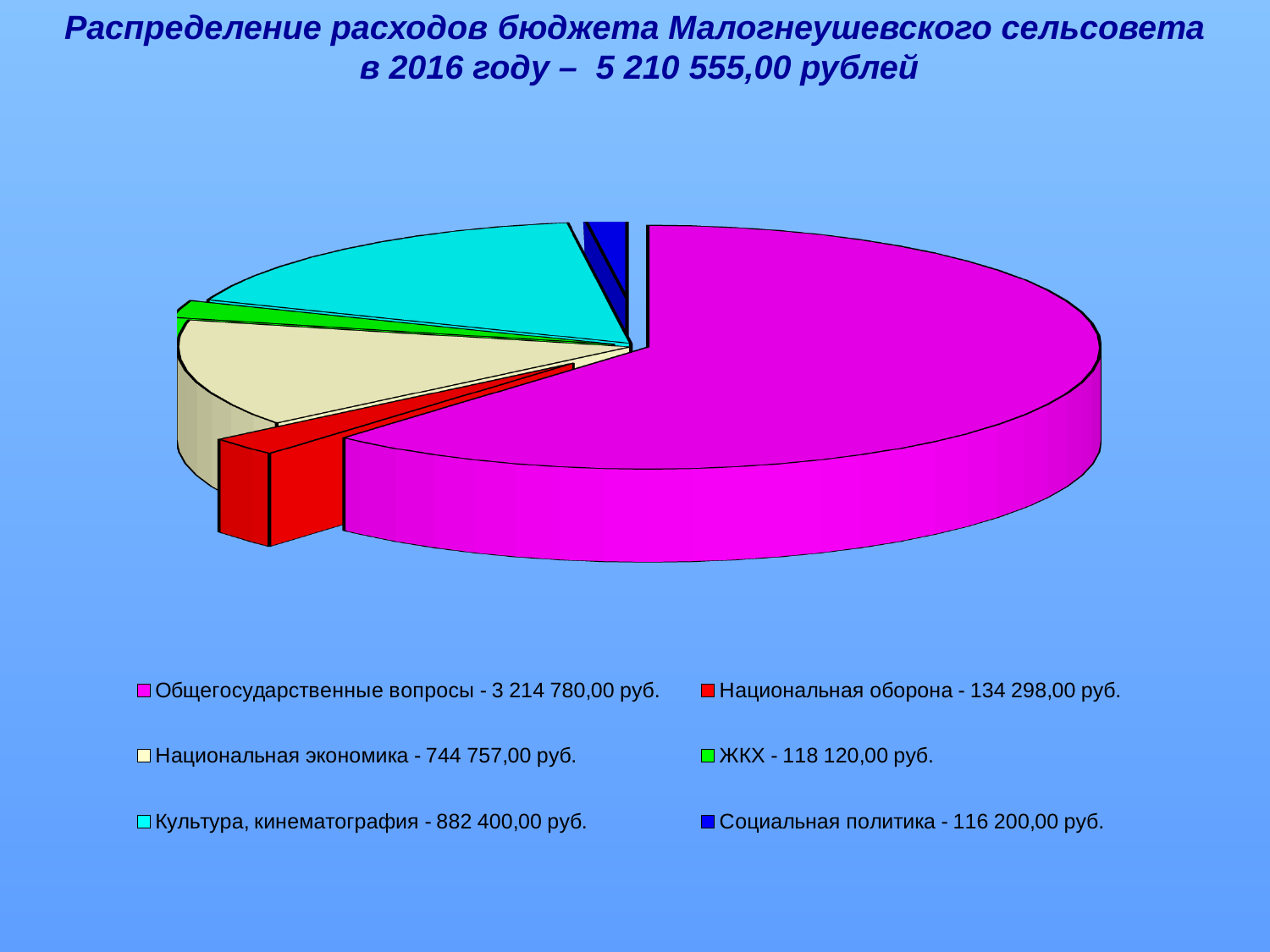
Which category has the largest share of the budget expenditures? Общегосударственные вопросы What is the total of all budget expenditures shown in the title? 5 210 555,00 рублей What is the value for Общегосударственные вопросы? 3 214 780,00 руб. What is the difference between Культура, кинематография and Национальная экономика? 137 643,00 руб. What is the value for Культура, кинематография? 882 400,00 руб. Which category has the smallest value in the legend? Социальная политика What is the value for Национальная оборона? 134 298,00 руб. What is the value for ЖКХ? 118 120,00 руб. Which is larger: Культура, кинематография or Национальная экономика? Культура, кинематография What kind of chart is shown on the slide? Pie chart What colour is the slice for Общегосударственные вопросы? Magenta (pink) How many categories does the pie chart show? 6